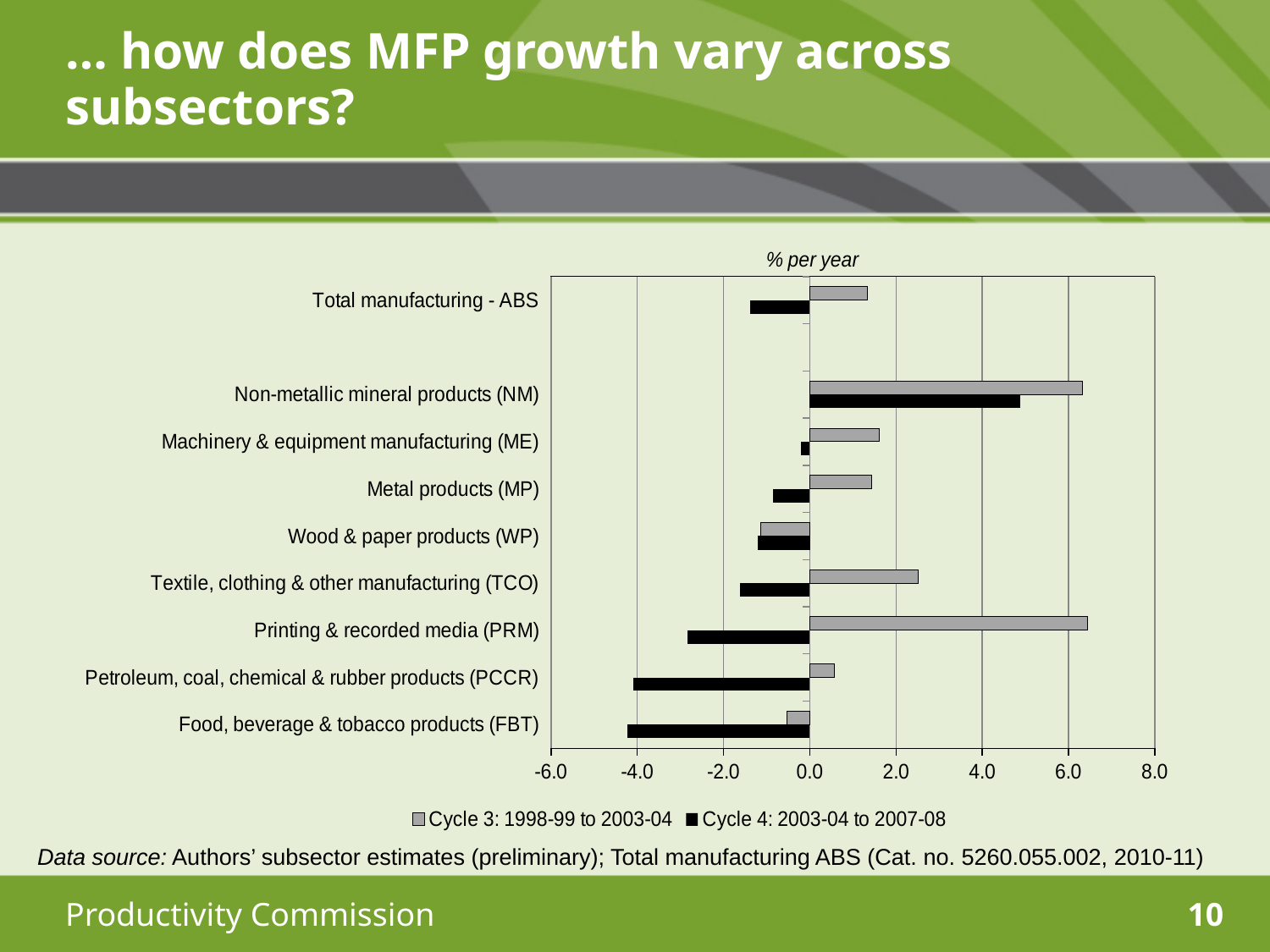
Is the Cycle 4 value for Non-metallic mineral products (NM) greater or less than 4.0? greater For Non-metallic mineral products (NM), which is larger: the Cycle 3 value or the Cycle 4 value? Cycle 3 Is the Cycle 3 value for Textile, clothing & other manufacturing (TCO) greater or less than 2.0? greater For Cycle 3, which is larger: Printing & recorded media (PRM) or Petroleum, coal, chemical & rubber products (PCCR)? Printing & recorded media (PRM) Which category has the highest value for Cycle 4: 2003-04 to 2007-08? Non-metallic mineral products (NM) What unit label is shown above the chart? % per year Which period does the black series in the legend represent? Cycle 4: 2003-04 to 2007-08 How many subsector categories (including Total manufacturing - ABS) are plotted on the chart? 9 Which category has the lowest value for Cycle 3: 1998-99 to 2003-04? Wood & paper products (WP) Is the Cycle 4 value for Printing & recorded media (PRM) greater or less than -2.0? less What kind of chart is shown on the slide? bar chart How many series does the legend list? 2